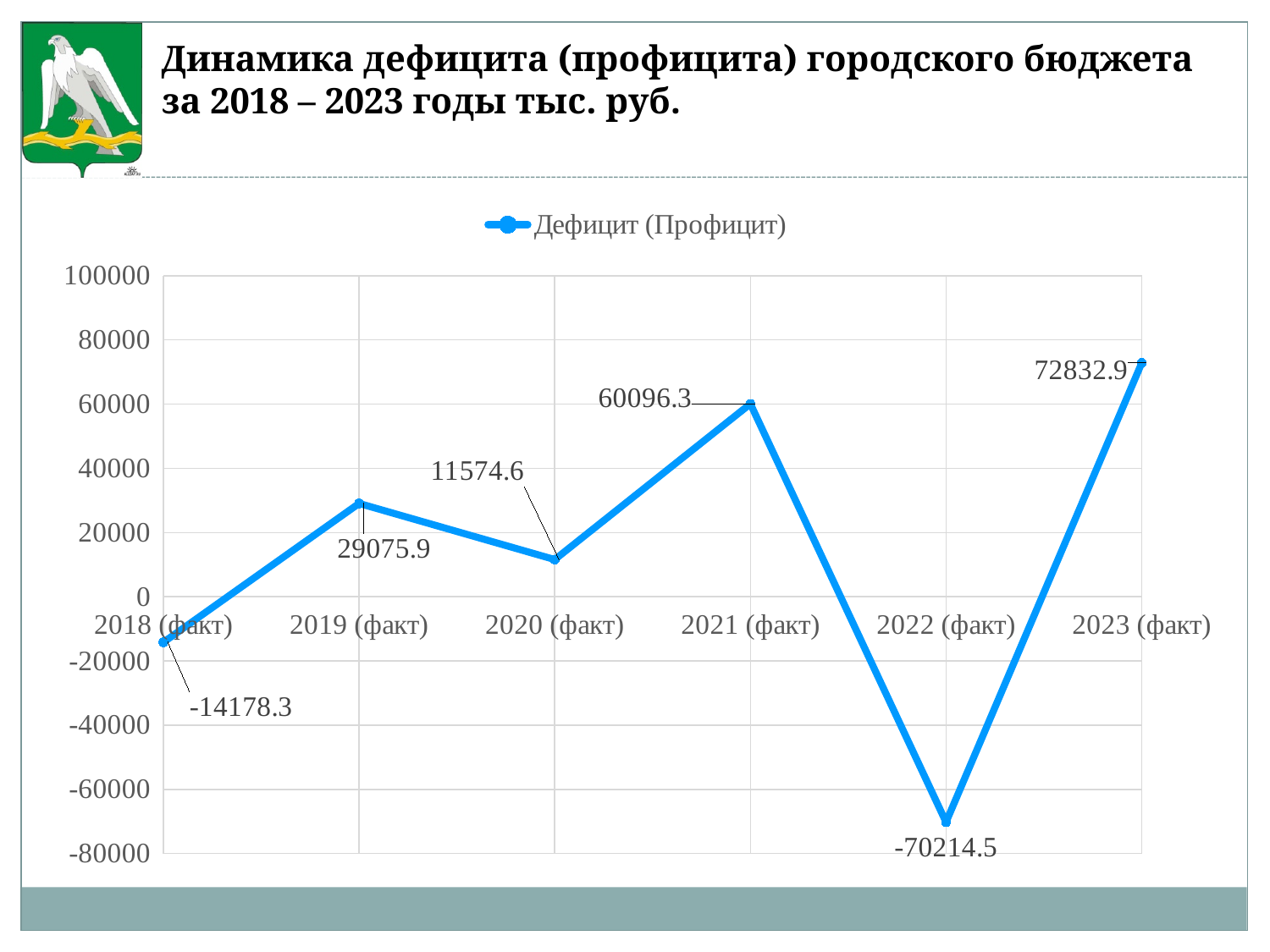
What is the name of the series shown in the legend? Дефицит (Профицит) Which year has the highest value? 2023 (факт) What is the difference between the values for 2023 (факт) and 2021 (факт)? 12736.6 Which is larger, the value for 2019 (факт) or the value for 2020 (факт)? 2019 (факт) How many series does the legend list? 1 What is the value for 2022 (факт)? -70214.5 What is the value for 2018 (факт)? -14178.3 Is the value for 2023 (факт) greater or less than 60000? greater What kind of chart is shown on the slide? line chart What is the value for 2021 (факт)? 60096.3 Which year has the lowest value? 2022 (факт) How many years are plotted on the x axis? 6